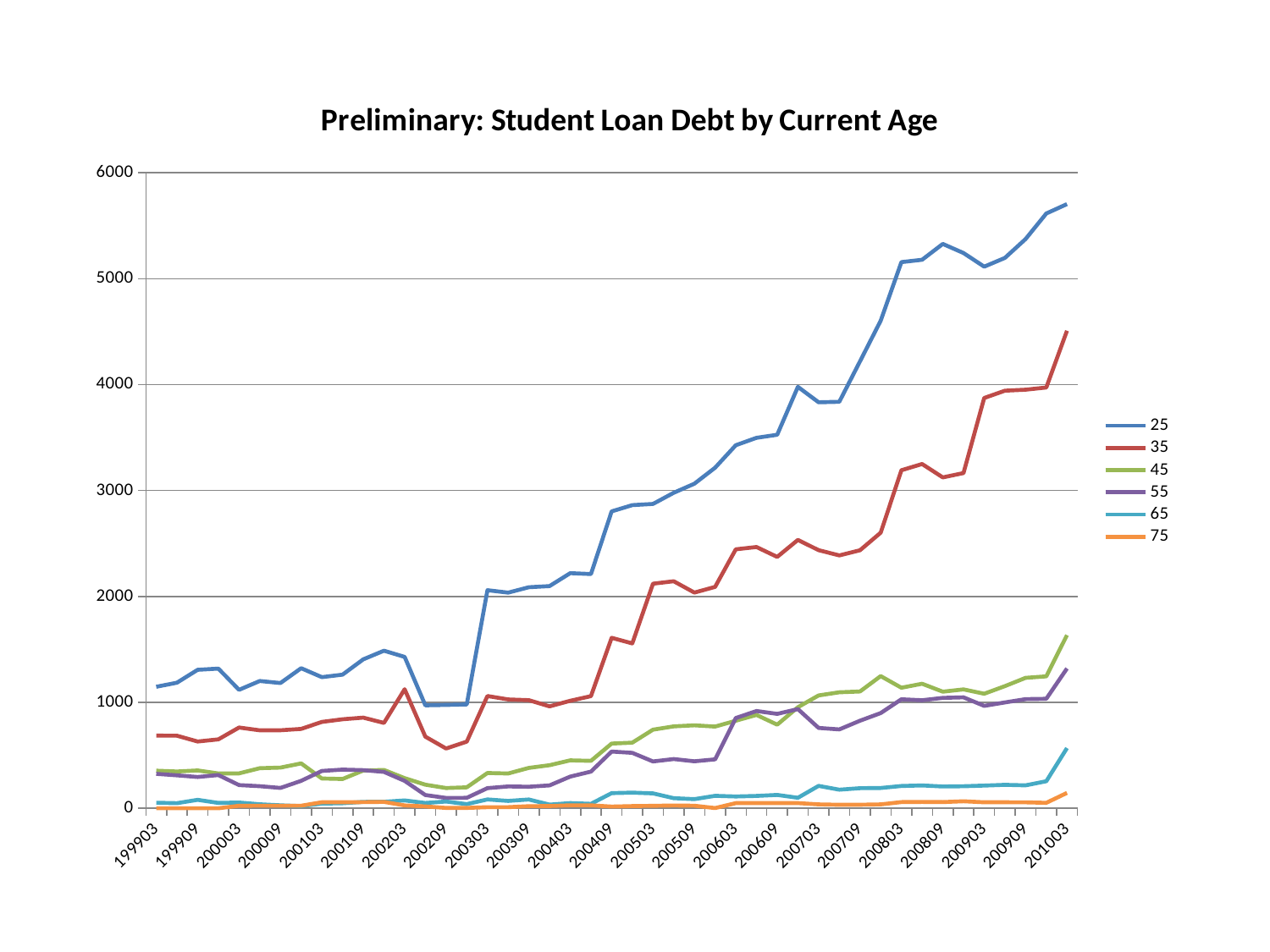
Is the value for the 35 series at 199903 greater or less than 1000? less What kind of chart is shown on the slide? line chart Is the value for the 35 series at 201003 greater or less than 4000? greater Is the value for the 45 series at 201003 greater or less than 2000? less At 201003, which is larger: the value for the 45 series or the 55 series? 45 What is the title of the chart? Preliminary: Student Loan Debt by Current Age How many tick labels are shown on the x axis? 23 Does the 25 series generally rise or fall from 199903 to 201003? rise Which series has the lowest value at 201003? 75 Which series has the highest value at 201003? 25 How many series does the legend list? 6